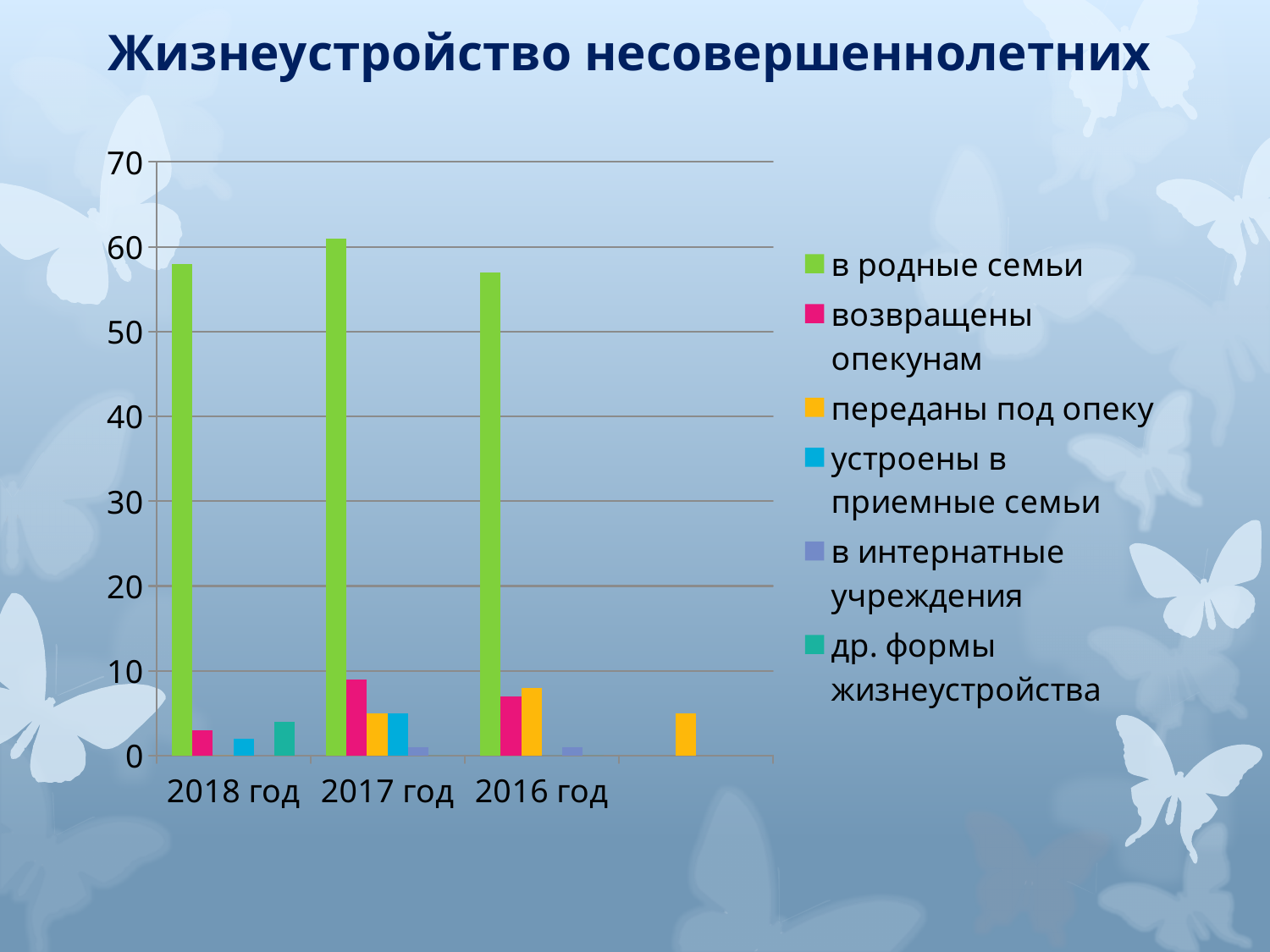
In 2018 год, which is larger: "в родные семьи" or "возвращены опекунам"? в родные семьи Is the value for "в родные семьи" in 2018 год greater or less than 50? greater What is the title of the chart? Жизнеустройство несовершеннолетних How many year labels appear on the x axis? 3 Is the value for "возвращены опекунам" in 2018 год greater or less than 10? less In which year is the bar for "в родные семьи" the highest? 2017 год How many series does the legend list? 6 Is the value for "в родные семьи" in 2016 год greater or less than 60? less What kind of chart is shown on the slide? bar chart In 2017 год, which is larger: "возвращены опекунам" or "переданы под опеку"? возвращены опекунам Which colour represents "в родные семьи" in the legend? green